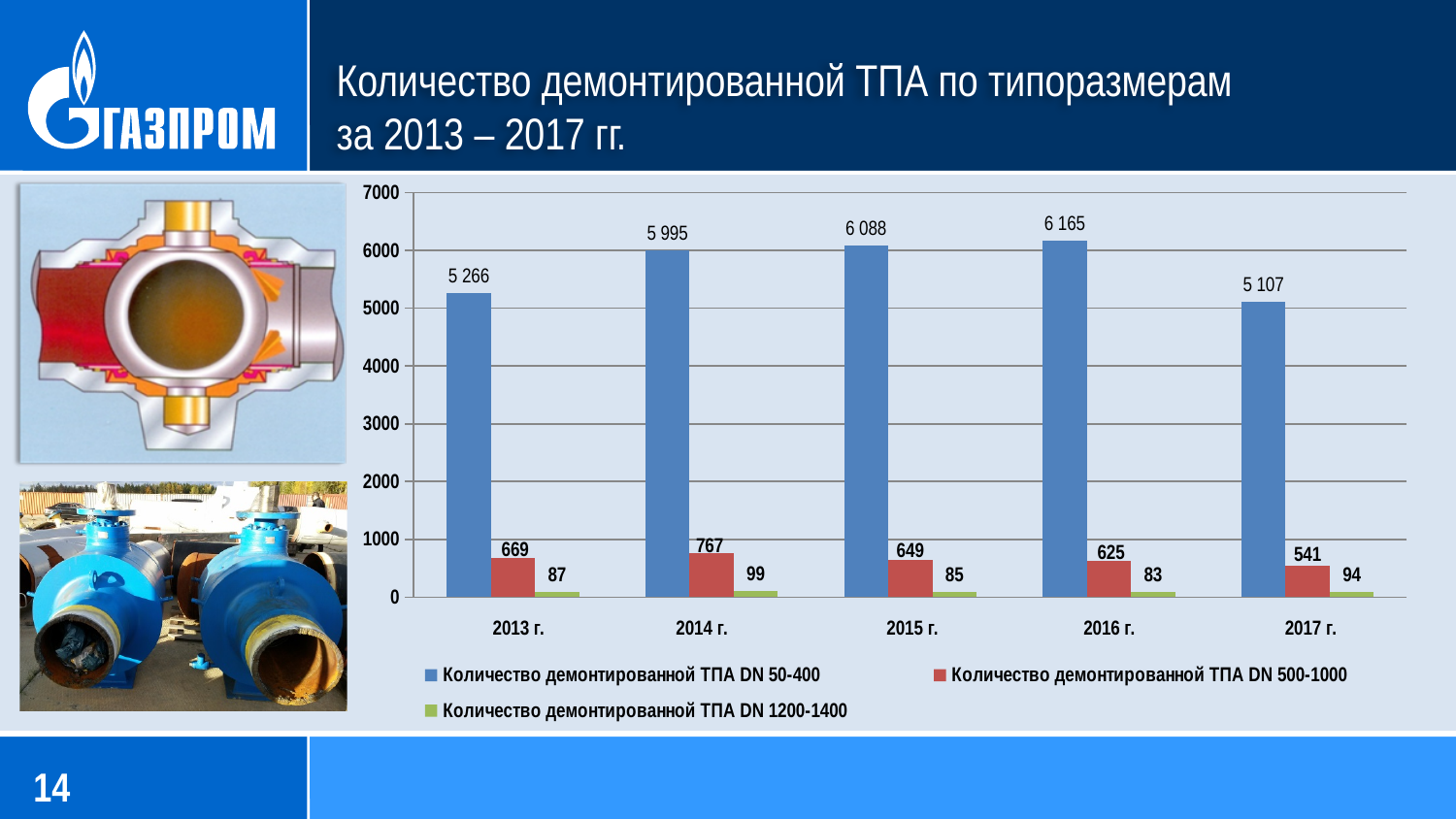
What kind of chart is shown? bar chart What is the value for DN 1200-1400 in 2015 г.? 85 What is the total of the three series for 2013 г.? 6 022 Is the DN 50-400 value for 2013 г. greater or less than 5000? greater How many years are shown on the x axis? 5 Which is larger: the DN 500-1000 value in 2014 г. or in 2015 г.? 2014 г. In which year is the DN 500-1000 value lowest? 2017 г. How many series does the legend list? 3 What is the value for DN 50-400 in 2014 г.? 5 995 In which year is the DN 50-400 value highest? 2016 г. What is the value for DN 500-1000 in 2017 г.? 541 What is the difference between the DN 50-400 values for 2016 г. and 2017 г.? 1 058